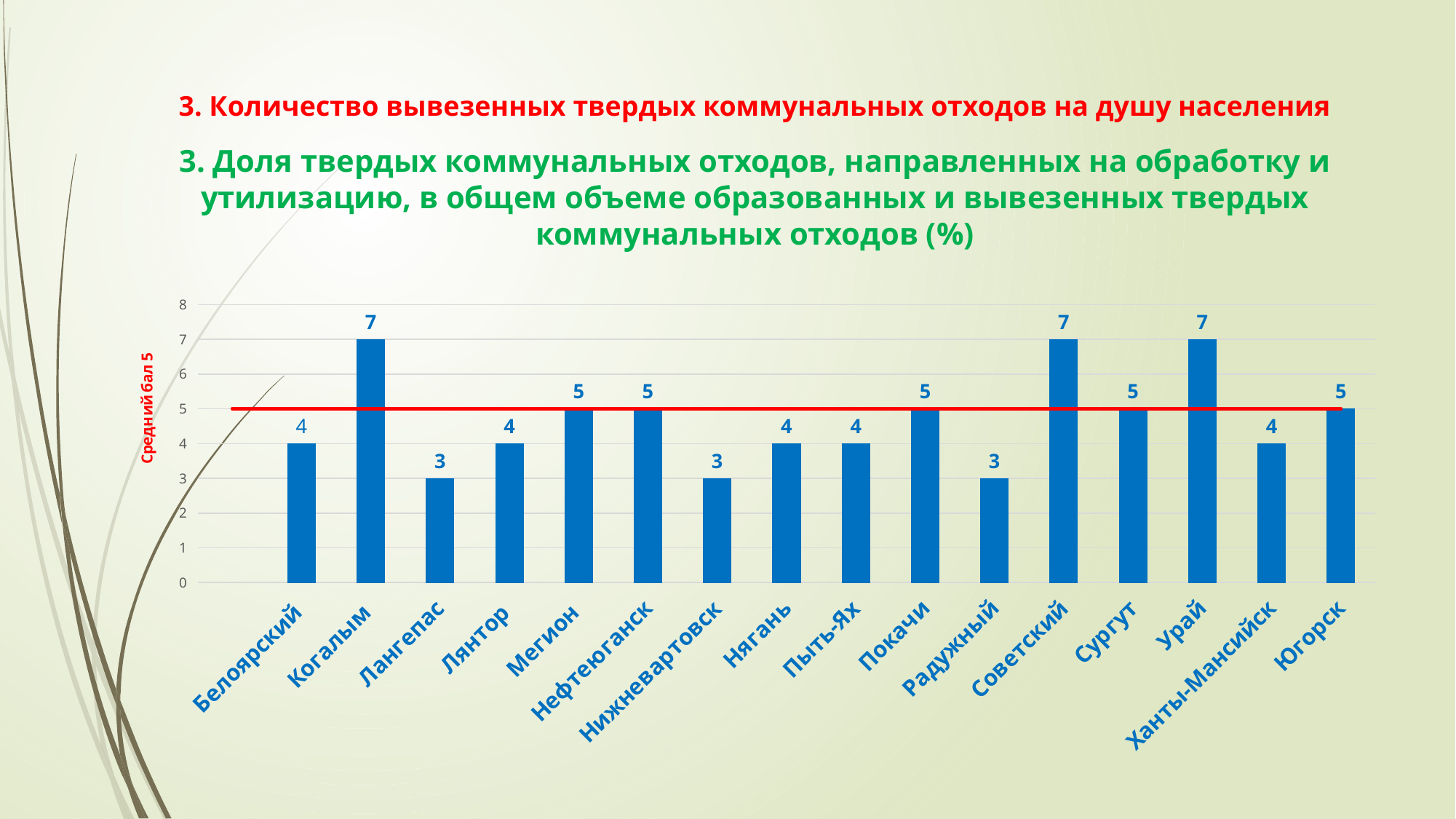
What is the value for Сургут? 5 What is the value for Ханты-Мансийск? 4 What is the difference between the values for Урай and Радужный? 4 Which has a larger value, Советский or Лянтор? Советский What is the value for Нижневартовск? 3 How many cities are shown on the x axis of the chart? 16 What kind of chart is shown on the slide? bar chart What is the value for Когалым? 7 What is the lowest value shown by any bar in the chart? 3 What is the highest value shown by any bar in the chart? 7 What value does the red horizontal line labelled 'Средний бал' mark on the chart? 5 Is the value for Лангепас greater or less than 4? less